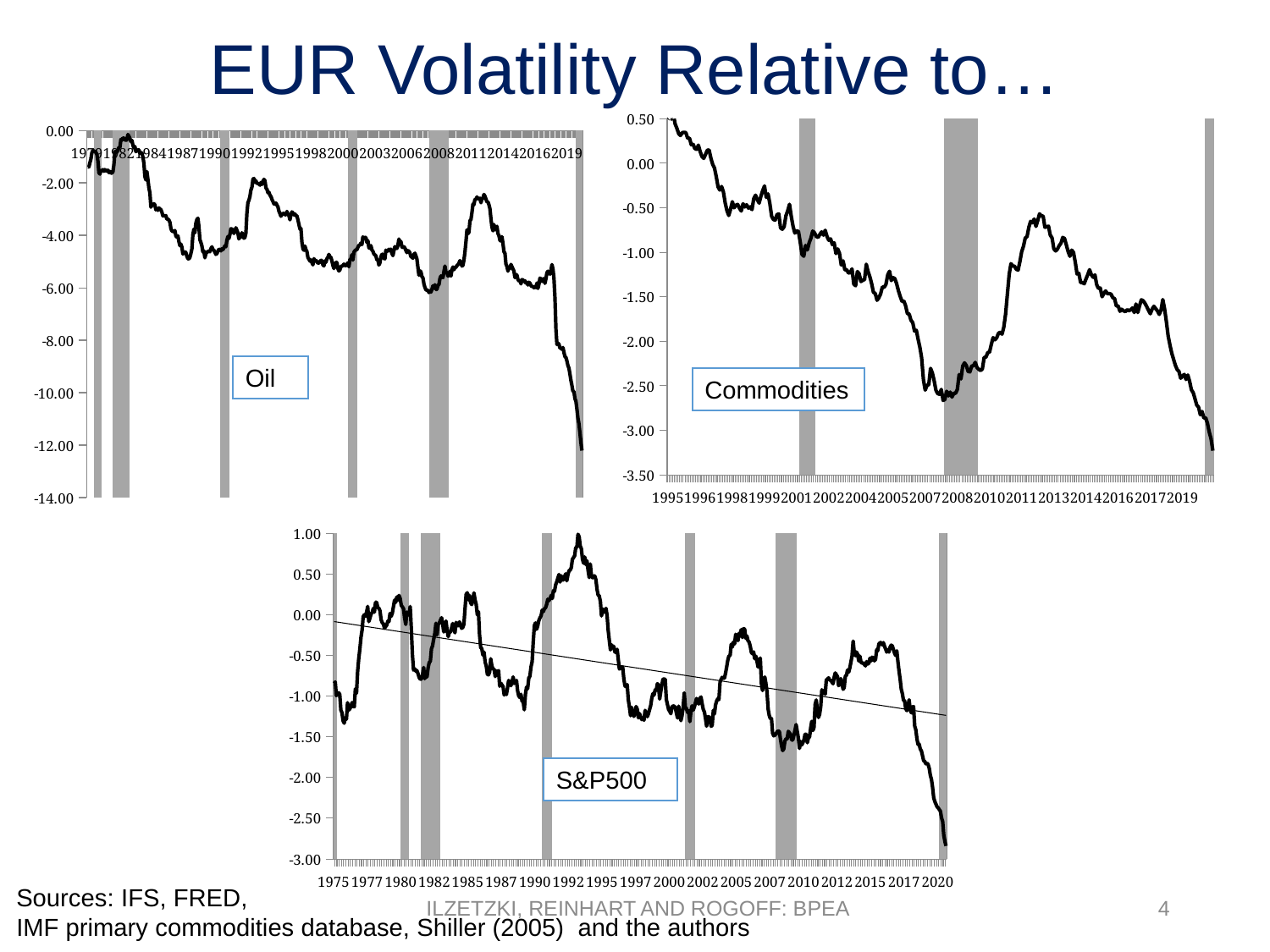
What is the lowest value shown on the y-axis of the Oil chart? -14.00 In the Oil chart, is the value at the end of the series (2020) greater or less than -10.00? less Which of the three charts has a straight downward trend line drawn through the data? S&P500 In the S&P500 chart, does the trend line slope upward or downward over time? downward What is the title of the slide? EUR Volatility Relative to… In the Commodities chart, is the value in 1995 higher or lower than the value in 2020? higher In the Commodities chart, is the value at the start of the series (1995) greater or less than 0.00? greater In the S&P500 chart, is the value at the end of the series (2020) greater or less than -2.00? less How many charts are shown on the slide? 3 In the Oil chart, does the line overall rise or fall from 1979 to 2020? fall What kind of chart is the Oil chart on the left? line chart